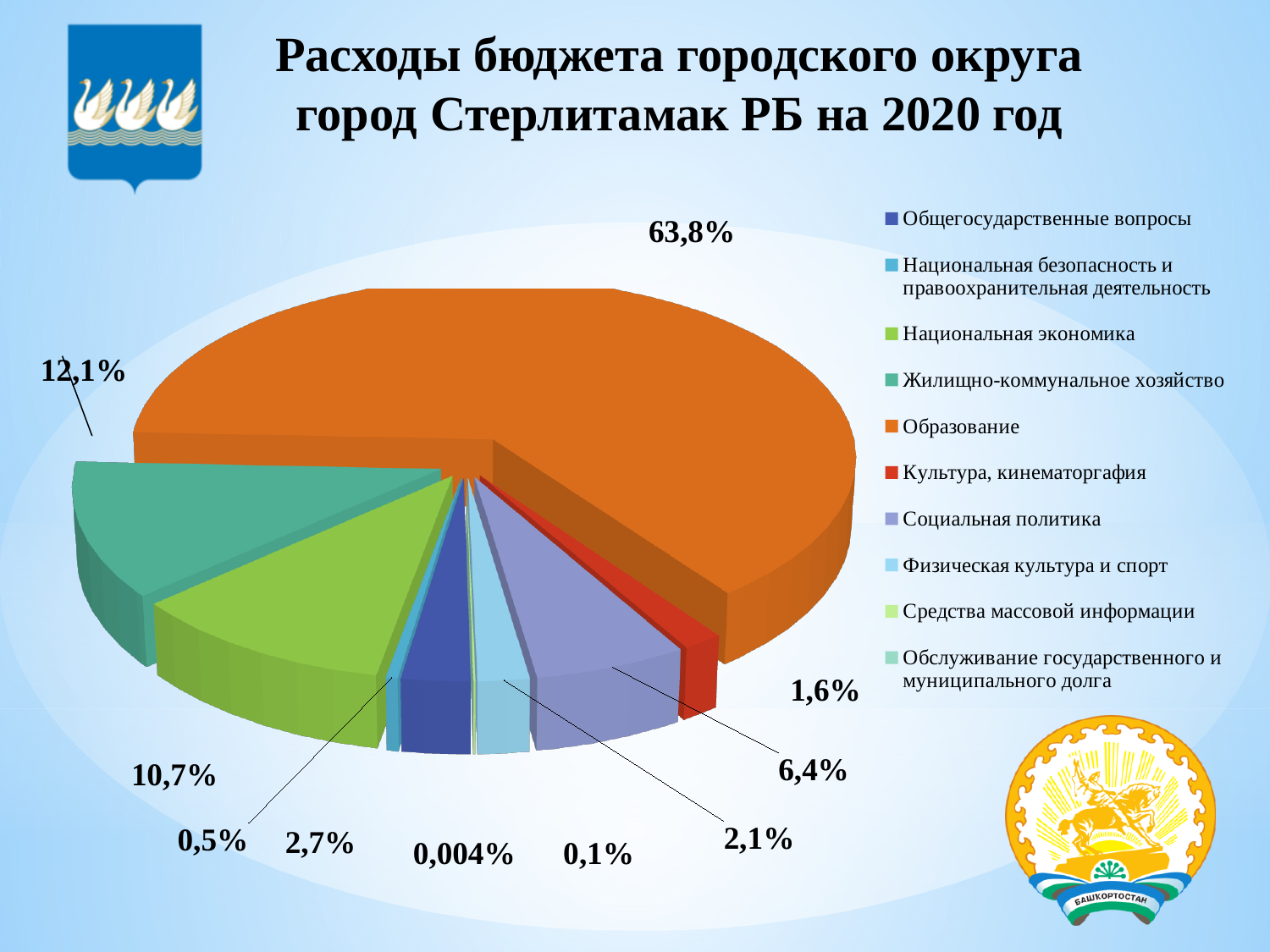
What is the difference between the shares for Образование and Жилищно-коммунальное хозяйство? 51,7% What share of the budget goes to Национальная экономика? 10,7% What kind of chart is shown on the slide? pie chart What is the smallest share shown on the chart? 0,004% What share of the budget goes to Культура, кинематоргафия? 1,6% Which is larger, the share for Жилищно-коммунальное хозяйство or for Национальная экономика? Жилищно-коммунальное хозяйство What is the title of the chart? Расходы бюджета городского округа город Стерлитамак РБ на 2020 год Which category has the largest share of the pie? Образование What share of the budget goes to Образование? 63,8% What share of the budget goes to Жилищно-коммунальное хозяйство? 12,1% What share of the budget goes to Социальная политика? 6,4% How many categories does the legend list? 10